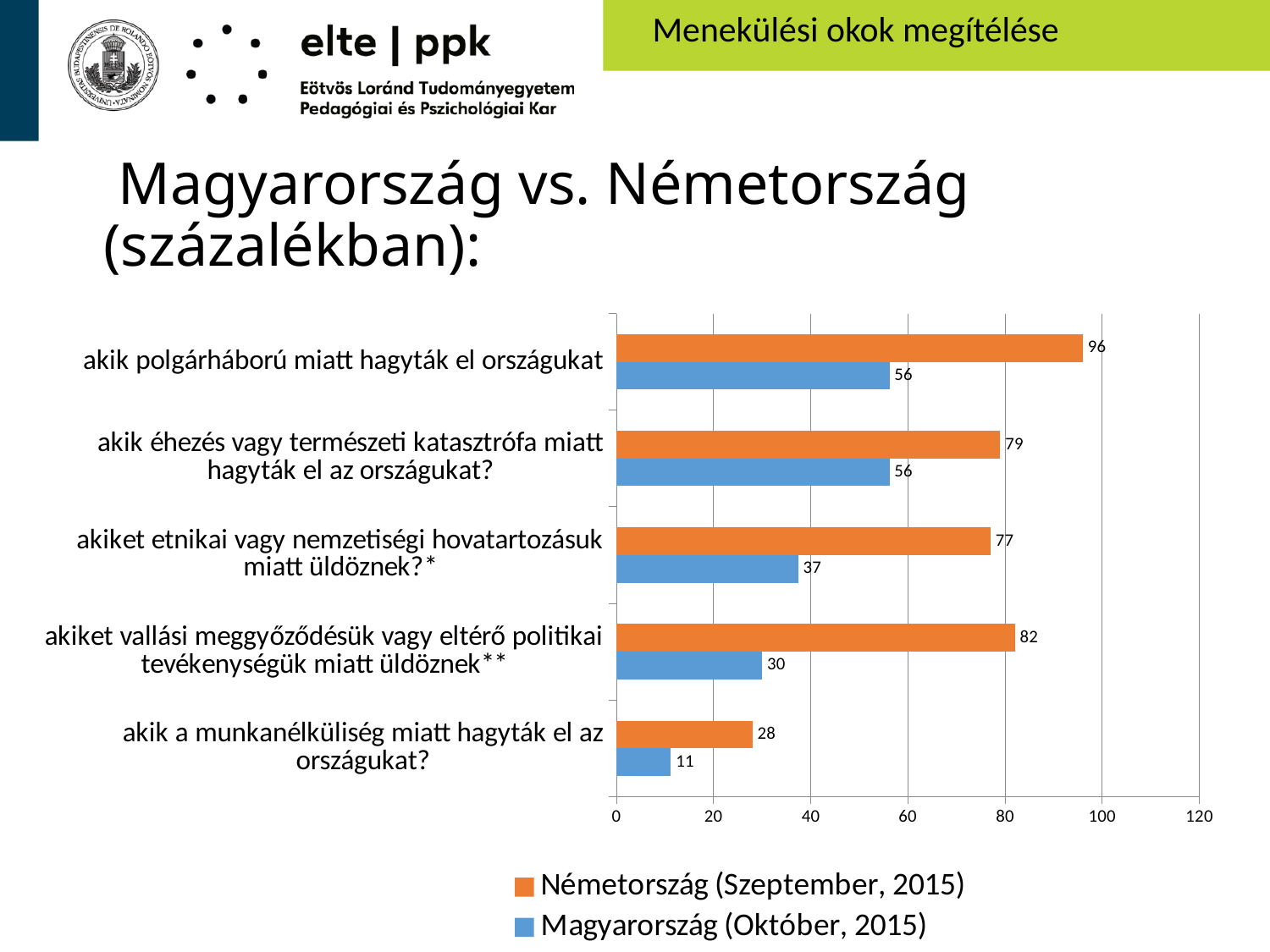
Which category has the lowest value for Magyarország (Október, 2015)? akik a munkanélküliség miatt hagyták el az országukat? What is the difference between the Németország and Magyarország values for 'akiket vallási meggyőződésük vagy eltérő politikai tevékenységük miatt üldöznek**'? 52 What is the value for Magyarország (Október, 2015) for 'akiket etnikai vagy nemzetiségi hovatartozásuk miatt üldöznek?*'? 37 How many series does the legend list? 2 How many categories are shown on the chart? 5 Which category has the highest value for Németország (Szeptember, 2015)? akik polgárháború miatt hagyták el országukat What is the value for Németország (Szeptember, 2015) for 'akik polgárháború miatt hagyták el országukat'? 96 Which colour represents Magyarország (Október, 2015) in the chart? blue For 'akik éhezés vagy természeti katasztrófa miatt hagyták el az országukat?', which series has the larger value, Németország (Szeptember, 2015) or Magyarország (Október, 2015)? Németország (Szeptember, 2015) What is the value for Magyarország (Október, 2015) for 'akik a munkanélküliség miatt hagyták el az országukat?'? 11 Is the Németország (Szeptember, 2015) value for 'akik a munkanélküliség miatt hagyták el az országukat?' greater or less than 40? less What kind of chart is shown on the slide? bar chart